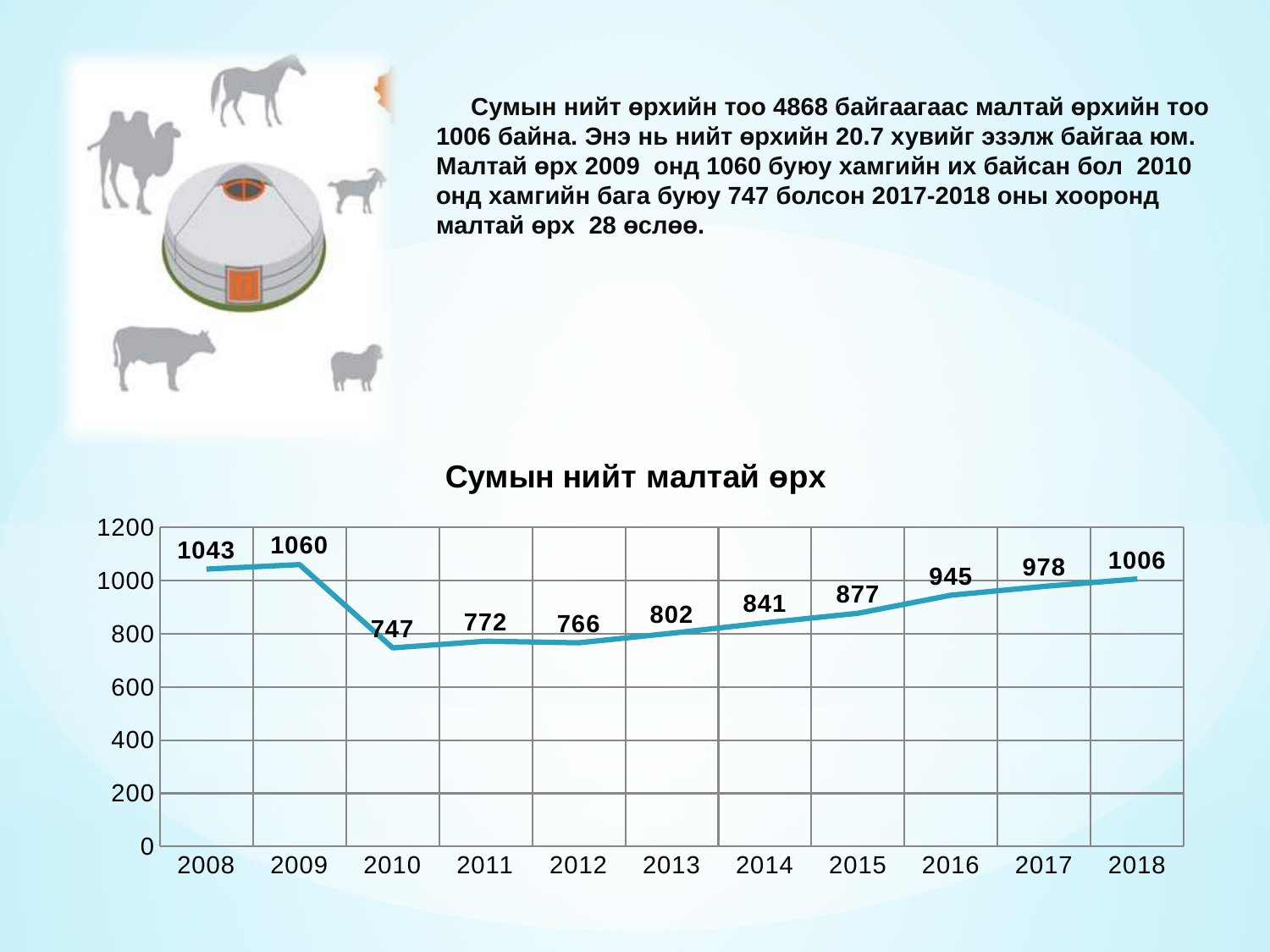
What is the difference between the values for 2018 and 2017? 28 How many years are plotted on the chart? 11 Which year has the highest value? 2009 Which is larger, the value for 2011 or the value for 2012? 2011 What kind of chart is shown? line chart What is the value for 2018? 1006 What is the title of the chart? Сумын нийт малтай өрх What is the difference between the values for 2009 and 2010? 313 Which year has the lowest value? 2010 What is the value for 2009? 1060 What is the value for 2014? 841 Is the value for 2015 greater or less than 800? greater